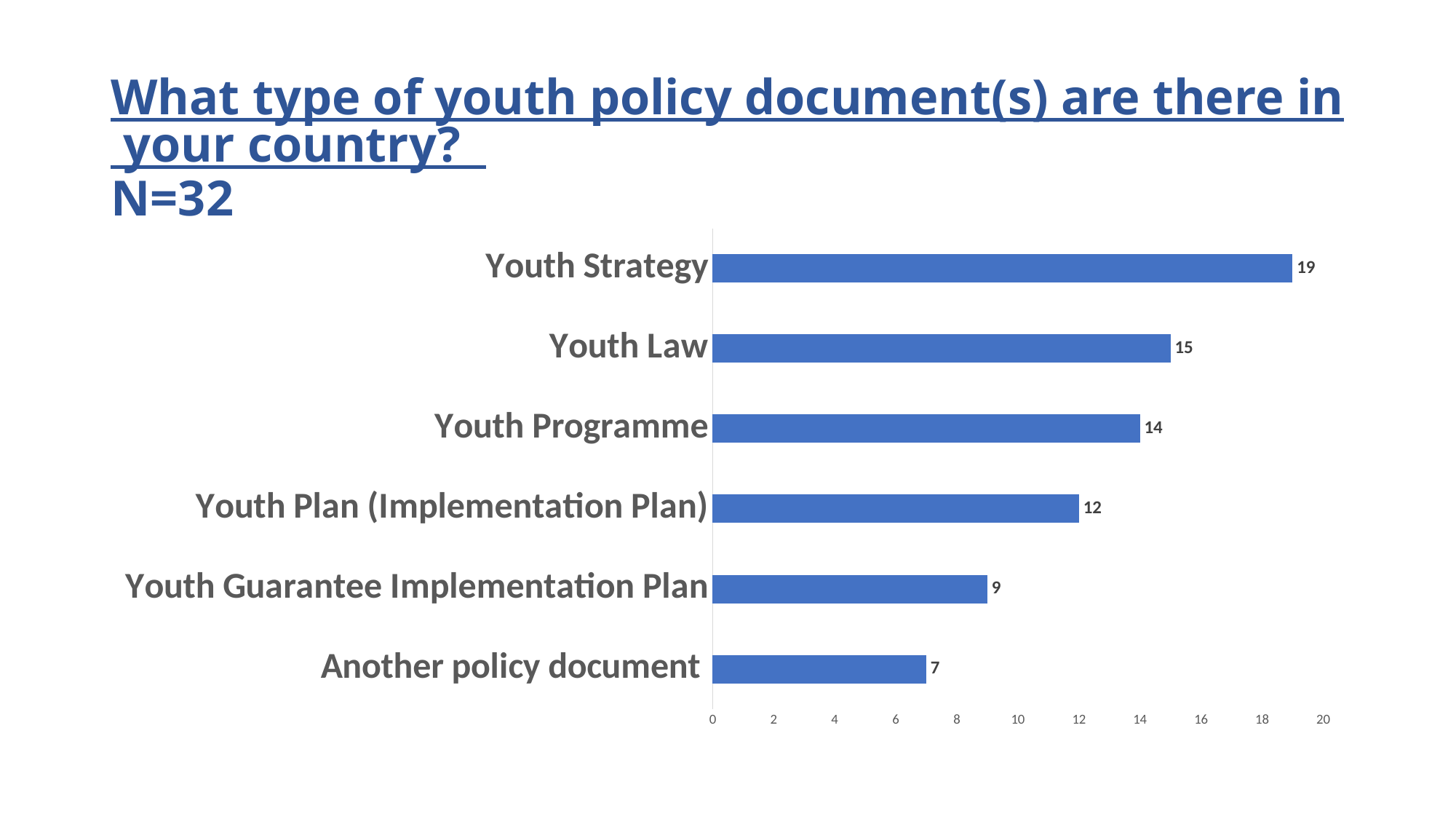
What is the value for Youth Strategy? 19 What kind of chart is shown on the slide? bar chart How many categories are shown in the chart? 6 What is the value for Youth Law? 15 What is the value for Youth Guarantee Implementation Plan? 9 Is the value for Youth Plan (Implementation Plan) greater or less than 10? greater Which is larger, the value for Youth Programme or the value for Youth Guarantee Implementation Plan? Youth Programme Which category has the lowest value? Another policy document What is the value for Another policy document? 7 What is the difference between the values for Youth Plan (Implementation Plan) and Another policy document? 5 Which category has the highest value? Youth Strategy What is the difference between the values for Youth Strategy and Youth Law? 4